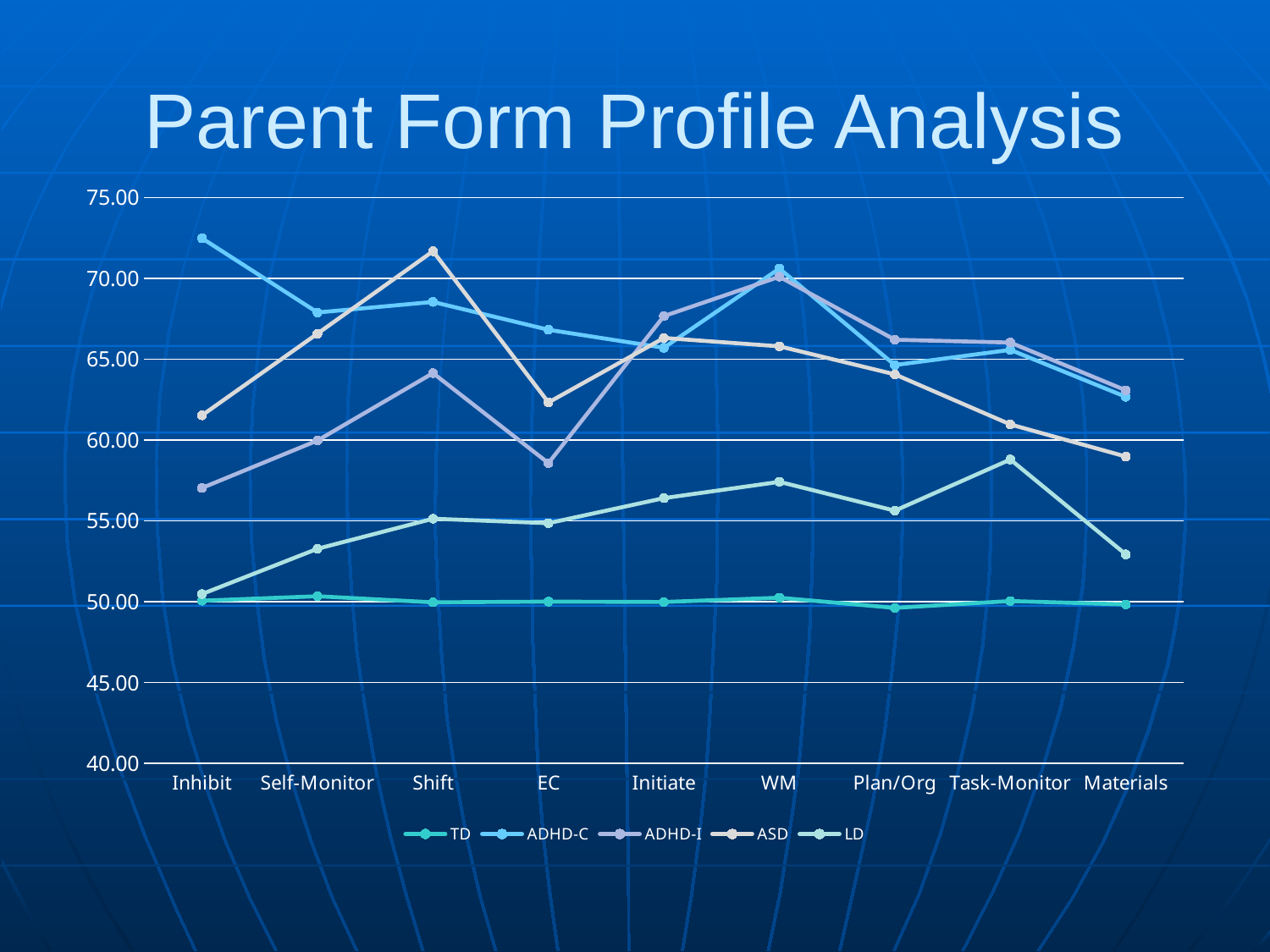
What kind of chart is shown on the slide? line chart Which series is highest at Inhibit? ADHD-C Is the value for ADHD-C at Inhibit greater or less than 70? greater For the ADHD-C series, which category has the highest value? Inhibit Which series is lowest across all categories? TD For the ASD series, which category has the highest value? Shift What is the title of the chart? Parent Form Profile Analysis Which is larger at Shift, ASD or ADHD-I? ASD Is the value for LD at Materials greater or less than 55? less How many categories are shown along the x axis? 9 Is the value for ADHD-I at Inhibit greater or less than 60? less How many series does the legend list? 5